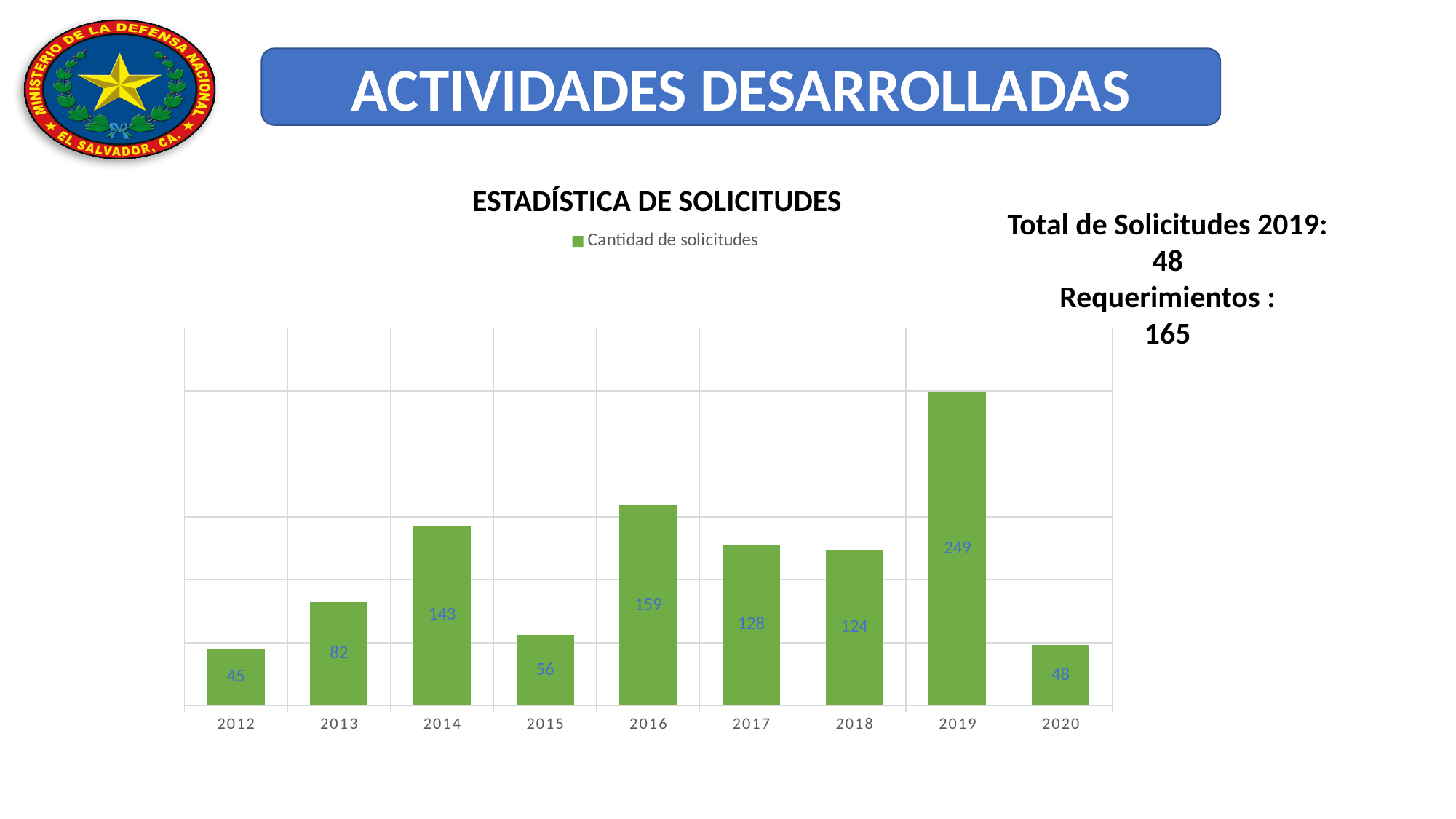
What kind of chart is shown? bar chart What is the value for 2019? 249 Which year has the lowest value? 2012 What is the difference between the values for 2019 and 2016? 90 What is the difference between the values for 2013 and 2012? 37 How many series does the legend list? 1 Which is larger, the value for 2017 or the value for 2018? 2017 What is the value for 2012? 45 What is the title of the chart? ESTADÍSTICA DE SOLICITUDES How many years are shown on the x axis? 9 What is the value for 2014? 143 Which year has the highest value? 2019